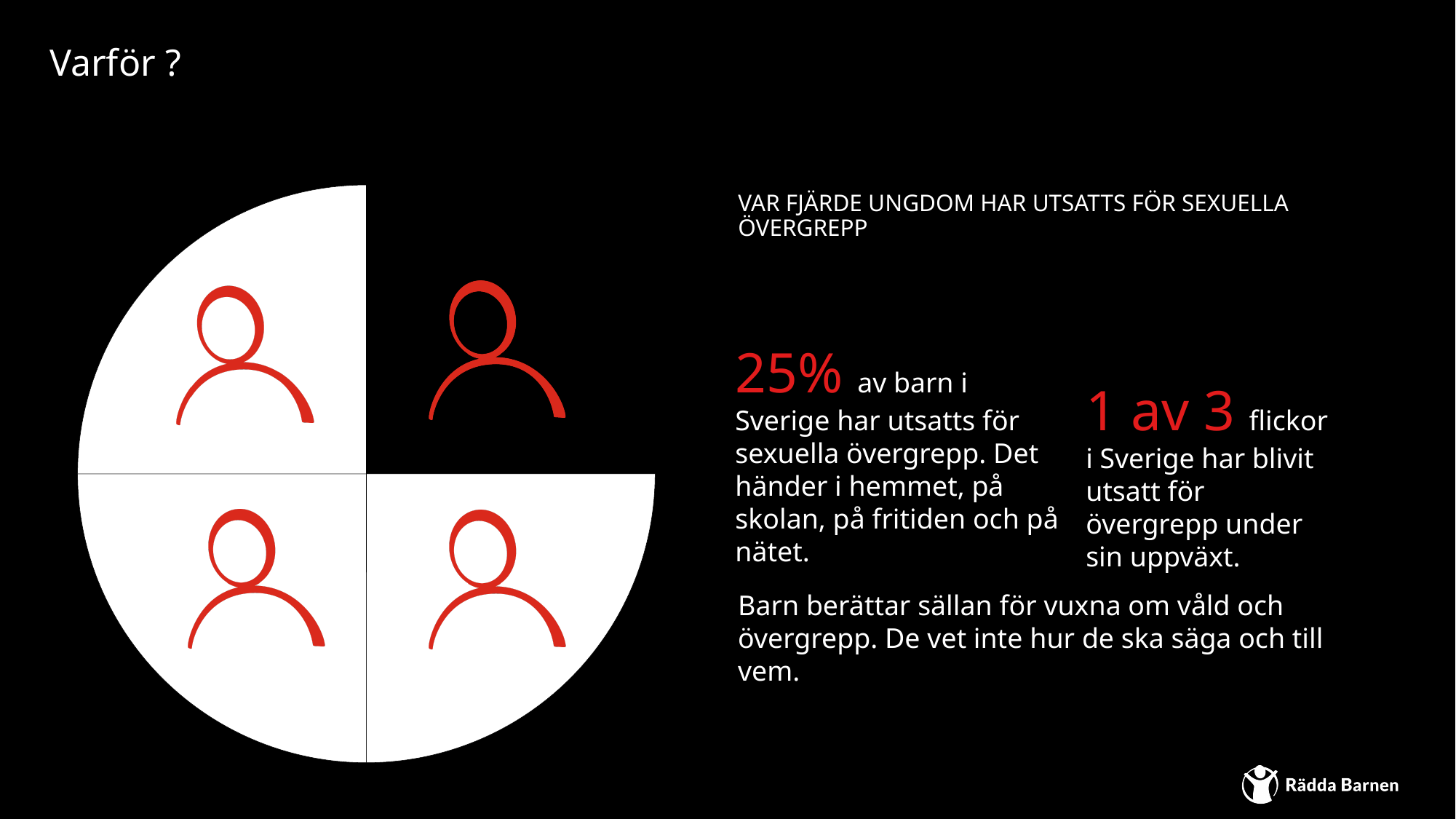
How many of the pie chart's quarter segments are filled white? 3 What colour are the person icons on the pie chart? red What kind of chart is shown on the left of the slide? pie chart How many equal segments is the pie chart on the left divided into? 4 What share of the pie does the single unfilled (black) quarter segment represent, according to the figure printed on the slide? 25% Which quarter of the pie chart is not filled white? the top-right quarter How many person icons are drawn on the pie chart? 4